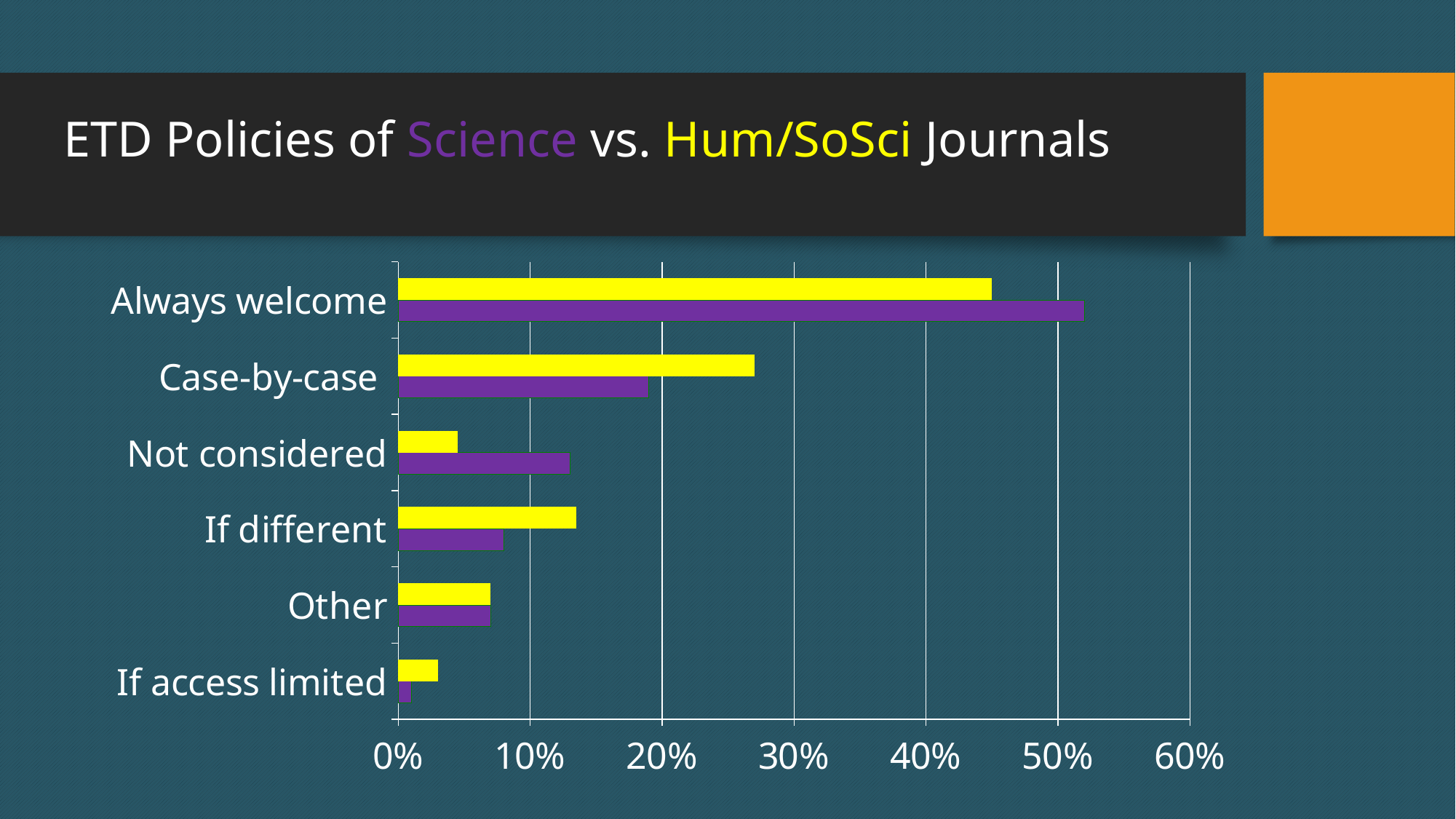
Is the value for Hum/SoSci journals in the 'Case-by-case' category greater or less than 30%? less What kind of chart is shown on the slide? bar chart Which category has the highest value for Hum/SoSci journals (yellow bars)? Always welcome How many policy categories are shown on the chart? 6 In the 'Case-by-case' category, which is larger: the Science value or the Hum/SoSci value? Hum/SoSci Is the value for Science journals in the 'Always welcome' category greater or less than 50%? greater Is the value for Science journals in the 'Not considered' category greater or less than 10%? greater What is the title of the slide containing the chart? ETD Policies of Science vs. Hum/SoSci Journals In the 'Always welcome' category, which is larger: the Science value or the Hum/SoSci value? Science Which category has the lowest value for Science journals (purple bars)? If access limited How many data series are plotted on the chart? 2 In the 'If different' category, which is larger: the Science value or the Hum/SoSci value? Hum/SoSci